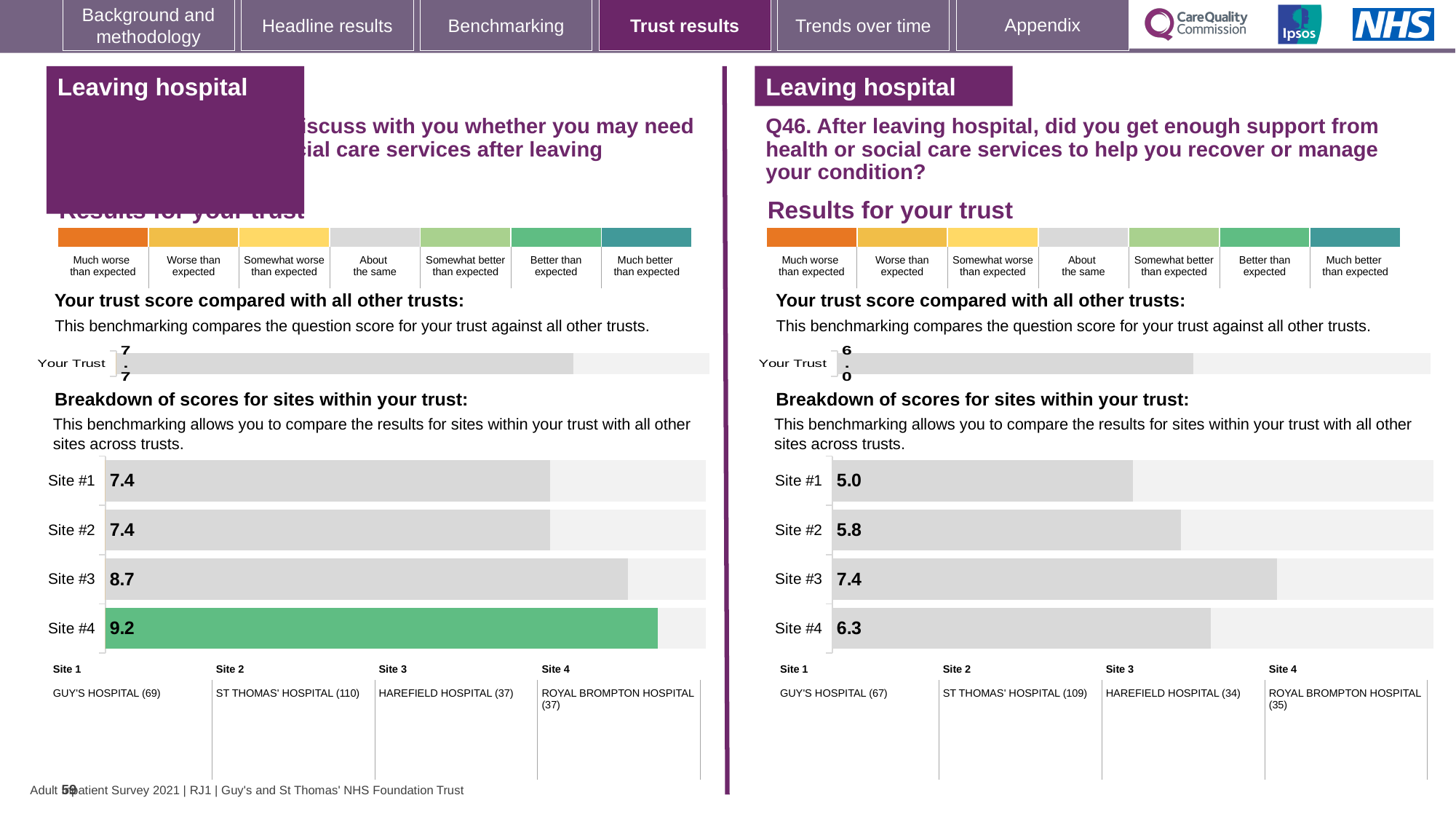
On the left-hand site breakdown chart, which site has the highest score? Site #4 On the right-hand (Q46) site breakdown chart, what is the score for Site #3? 7.4 On the left-hand site breakdown chart, which site's bar is coloured green rather than grey? Site #4 On the right-hand (Q46) site breakdown chart, which has the larger score, Site #2 or Site #4? Site #4 How many sites are shown on the right-hand (Q46) site breakdown chart? 4 On the left-hand site breakdown chart, which has the larger score, Site #1 or Site #3? Site #3 On the left-hand site breakdown chart, what is the score for Site #4? 9.2 On the right-hand (Q46) site breakdown chart, what is the difference between the scores for Site #3 and Site #1? 2.4 On the left-hand site breakdown chart, what is the difference between the scores for Site #4 and Site #3? 0.5 What type of chart is used for the site breakdown on the left-hand side of the slide? Bar chart On the right-hand (Q46) site breakdown chart, which site has the lowest score? Site #1 On the right-hand (Q46) 'Your trust score compared with all other trusts' chart, what is the score for Your Trust? 6.0